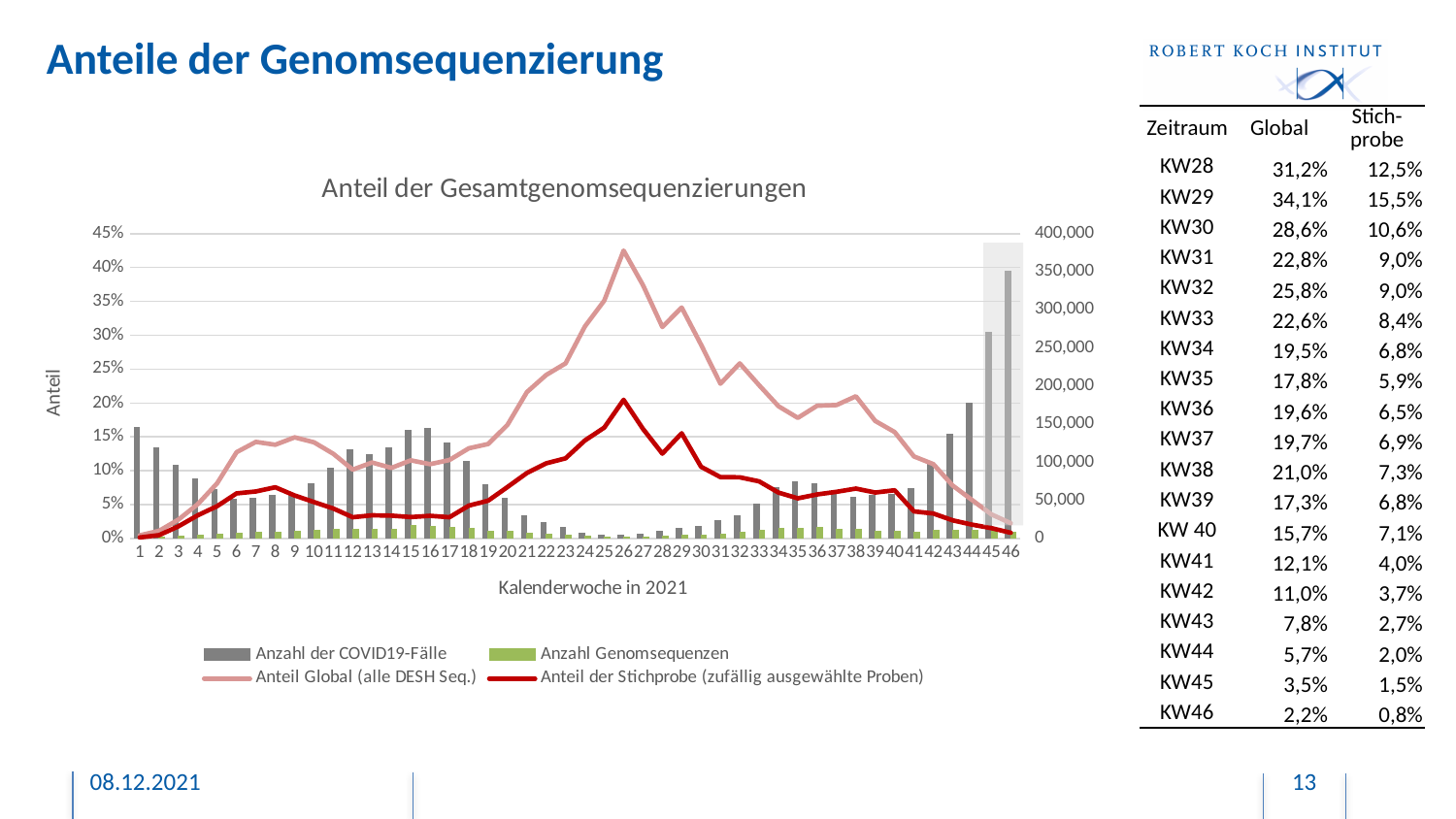
Is the value of 'Anzahl der COVID19-Fälle' in calendar week 26 greater or less than 50,000? less How many calendar weeks are shown on the x axis of the chart? 46 According to the table on the slide, what is the difference between the Global share and the Stichprobe share for KW28? 18,7% In which calendar week does the 'Anteil Global (alle DESH Seq.)' line reach its highest value? 26 Does the 'Anteil Global (alle DESH Seq.)' line rise or fall from calendar week 26 to calendar week 46? fall What kind of chart is shown on the slide? A combined bar and line chart How many series does the chart legend list? 4 According to the table on the slide, what is the Stichprobe share for KW46? 0,8% What is the title of the chart on the slide? Anteil der Gesamtgenomsequenzierungen According to the table on the slide, what is the Global share for KW28? 31,2% Is the value of 'Anzahl der COVID19-Fälle' in calendar week 46 greater or less than 300,000? greater Is the value of 'Anteil Global (alle DESH Seq.)' in calendar week 26 greater or less than 40%? greater